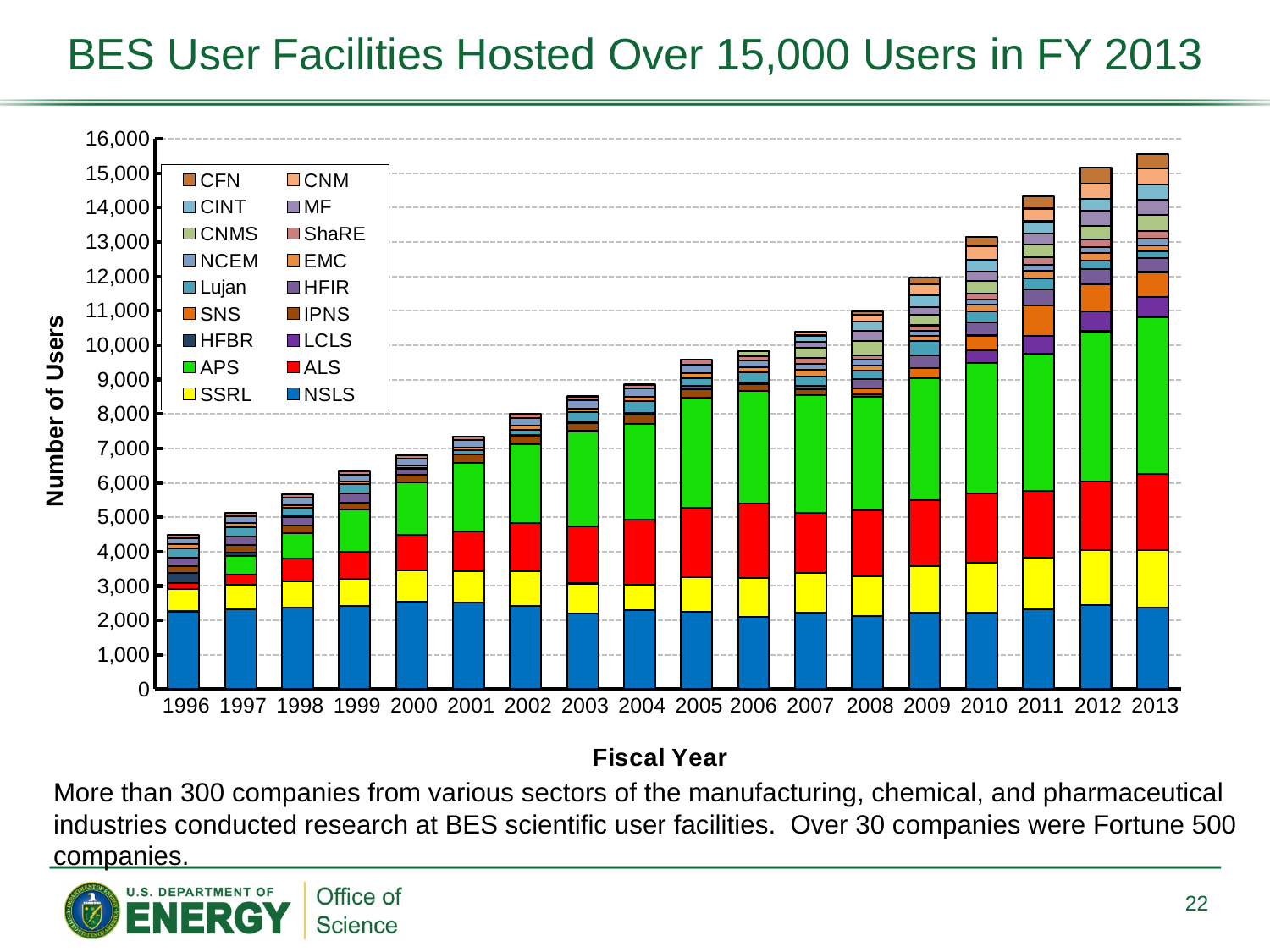
Is the total number of users in FY 1996 greater or less than 5,000? less How many fiscal years are shown along the x axis? 18 Do the total number of users generally rise or fall from 1996 to 2013? rise What kind of chart is shown on the slide? stacked bar chart Is the total number of users in FY 2008 greater or less than 10,000? greater Which fiscal year has a larger total number of users, 2009 or 2012? 2012 Is the total number of users in FY 2005 greater or less than 10,000? less Which fiscal year has the highest total number of users? 2013 How many series does the legend list? 18 Which fiscal year has the lowest total number of users? 1996 What is the label on the y axis of the chart? Number of Users